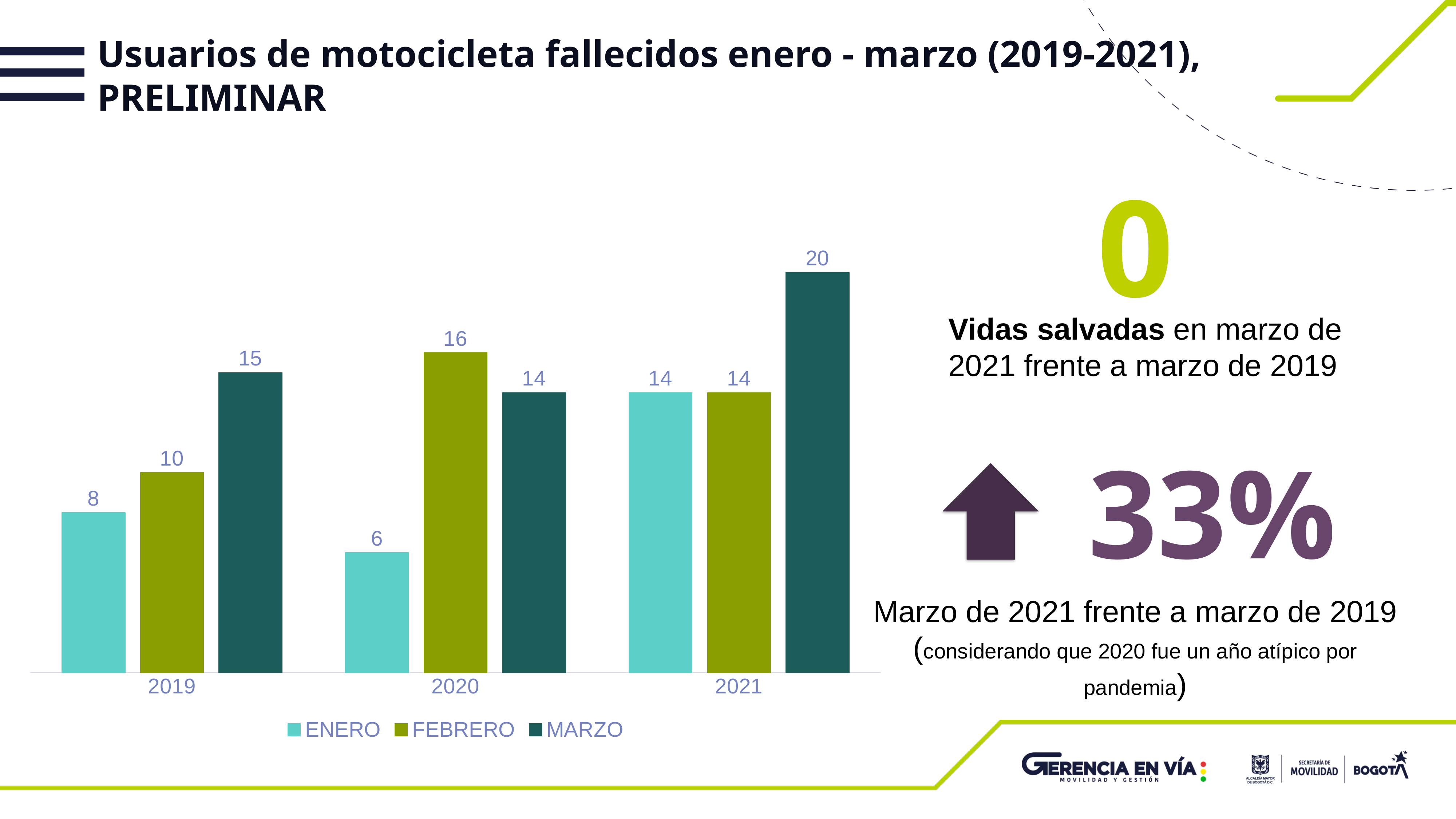
What is the value for FEBRERO in 2020? 16 Which year has the highest MARZO value? 2021 What is the value for MARZO in 2021? 20 How many years are shown on the x axis? 3 How many series does the legend list? 3 What is the value for ENERO in 2019? 8 Which is larger, FEBRERO in 2020 or FEBRERO in 2019? FEBRERO in 2020 What kind of chart is shown on the slide? Bar chart What is the difference between the MARZO values for 2021 and 2019? 5 Which year has the lowest ENERO value? 2020 What is the value for ENERO in 2020? 6 Do the ENERO values rise or fall from 2020 to 2021? Rise